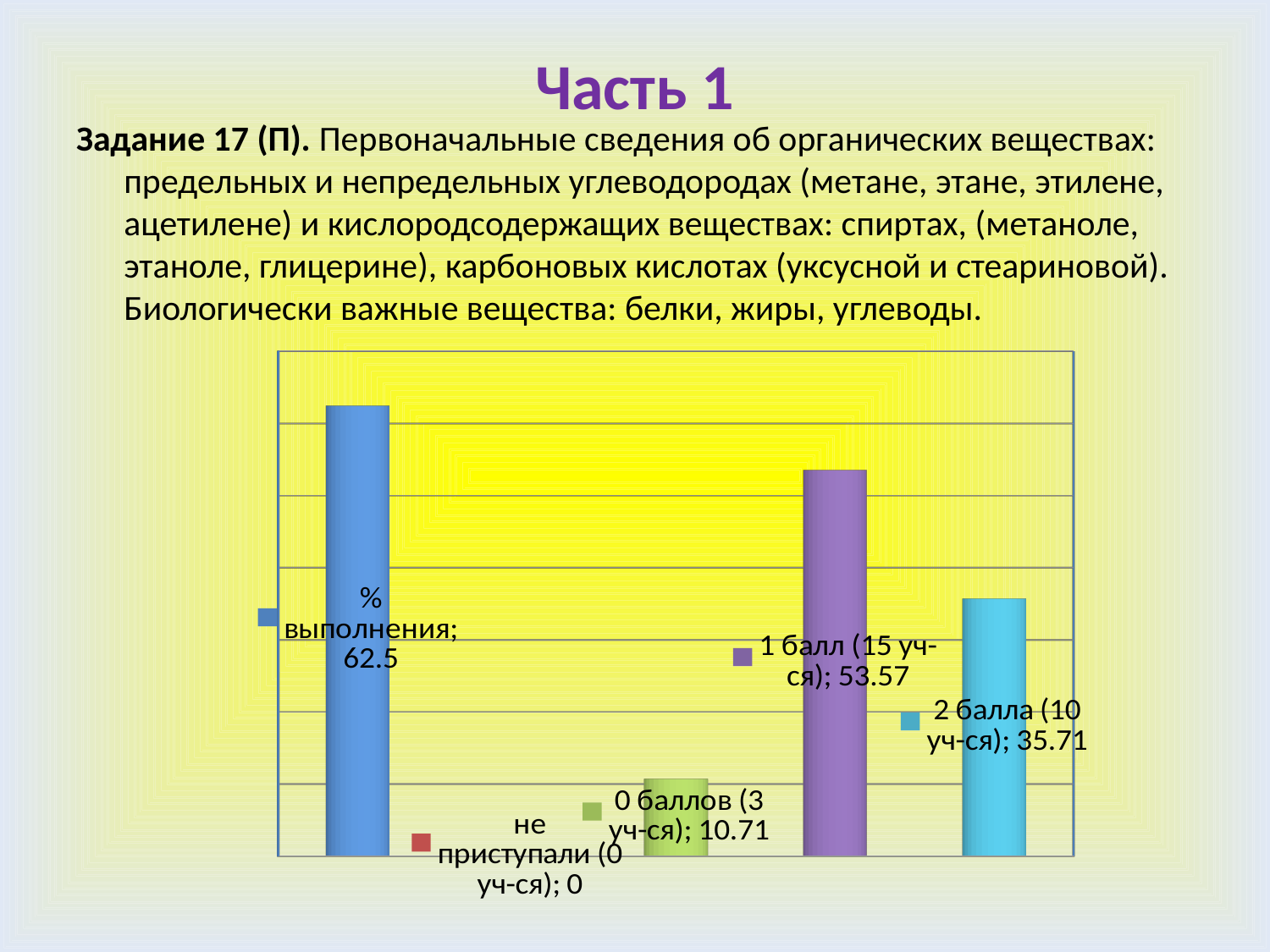
What is the value labelled for "не приступали (0 уч-ся)"? 0 What is the value labelled for "% выполнения"? 62.5 What kind of chart is shown on the slide? bar chart Which is larger, the value for "0 баллов (3 уч-ся)" or the value for "2 балла (10 уч-ся)"? 2 балла (10 уч-ся) How many bars are plotted in the chart? 4 What is the difference between the values for "1 балл (15 уч-ся)" and "2 балла (10 уч-ся)"? 17.86 Which category has the highest value in the chart? % выполнения Which category has the lowest value in the chart? не приступали (0 уч-ся) What is the value labelled for "0 баллов (3 уч-ся)"? 10.71 What is the value labelled for "2 балла (10 уч-ся)"? 35.71 What colour is the bar for "1 балл (15 уч-ся)"? purple What is the value labelled for "1 балл (15 уч-ся)"? 53.57